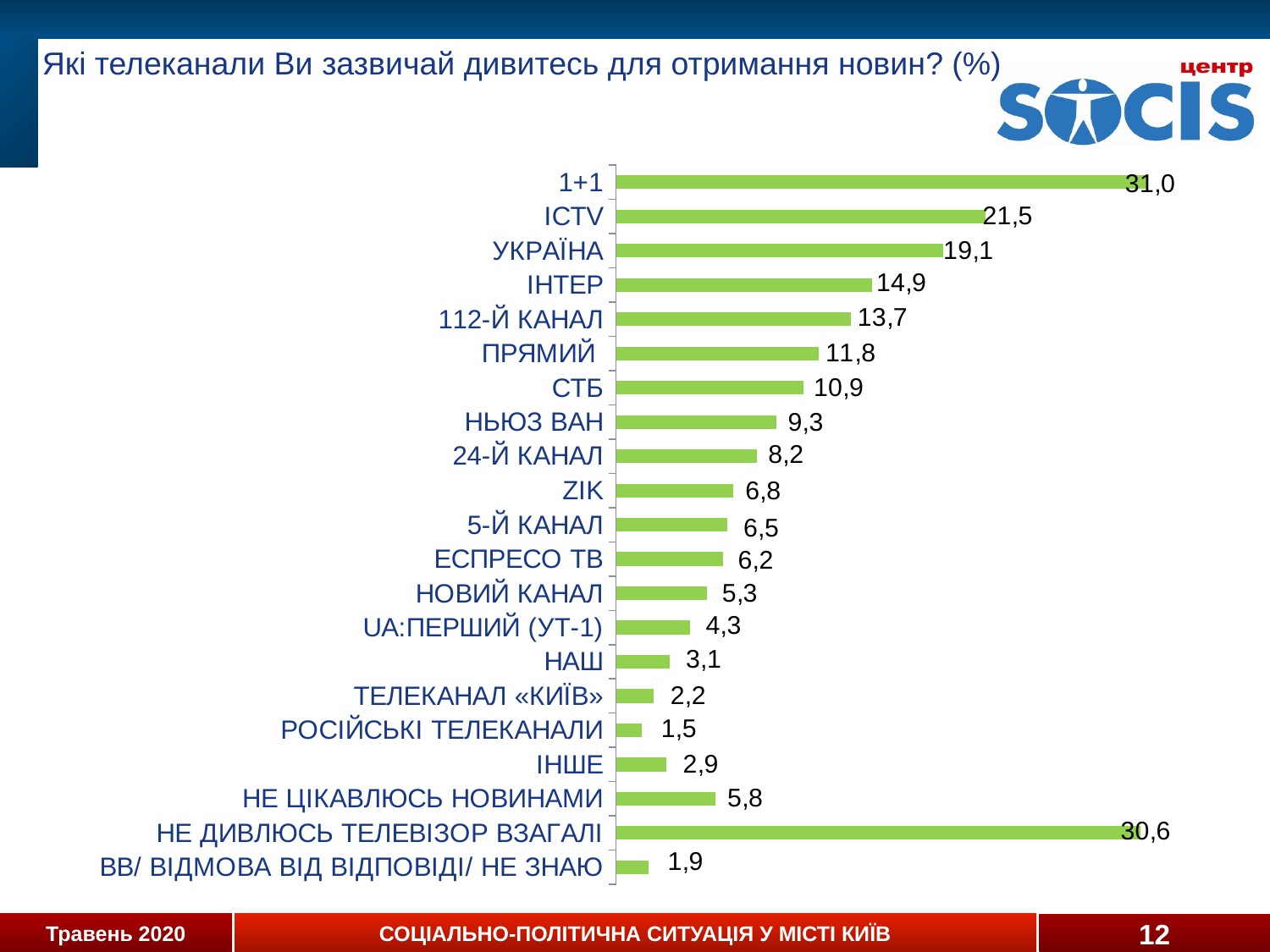
What is the value for 112-Й КАНАЛ? 13,7 Which has a larger value, ПРЯМИЙ or СТБ? ПРЯМИЙ What is the difference between the values for ICTV and УКРАЇНА? 2,4 How many categories are shown in the chart? 21 What is the difference between the values for 1+1 and ICTV? 9,5 Which category has the lowest value in the chart? РОСІЙСЬКІ ТЕЛЕКАНАЛИ What is the value shown for ICTV? 21,5 What percentage of respondents usually watch 1+1 for news? 31,0 What type of chart is shown on the slide? Bar chart What value is shown for НЕ ДИВЛЮСЬ ТЕЛЕВІЗОР ВЗАГАЛІ? 30,6 Which TV channel has the highest value in the chart? 1+1 Which has a larger value, НЕ ЦІКАВЛЮСЬ НОВИНАМИ or НОВИЙ КАНАЛ? НЕ ЦІКАВЛЮСЬ НОВИНАМИ